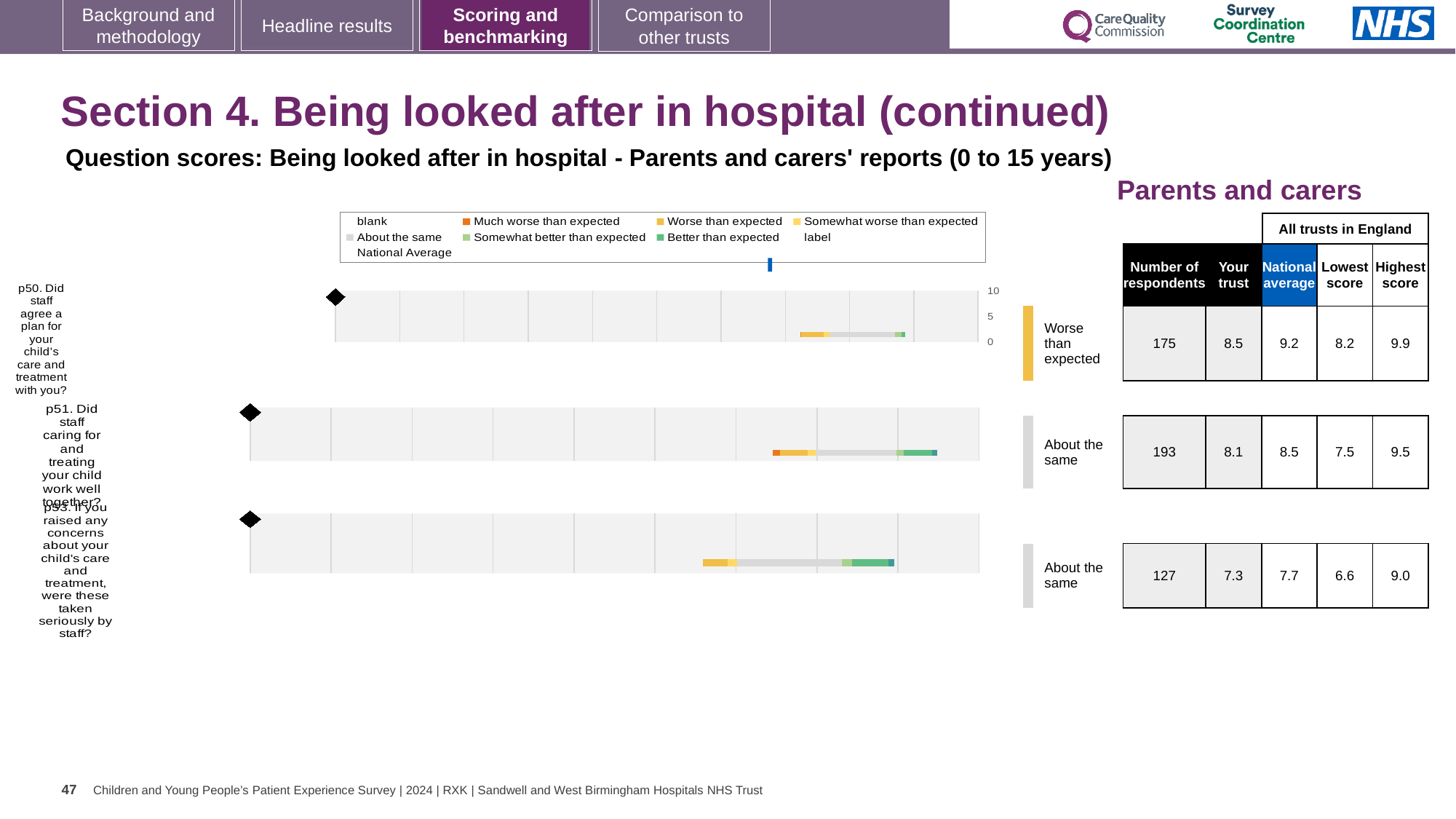
For p53, what is the difference between the national average and the 'Your trust' score? 0.4 What is the 'Your trust' score for p50 (Did staff agree a plan for your child's care and treatment with you?)? 8.5 What is the national average score for p51 (Did staff caring for and treating your child work well together?)? 8.5 Which question has the lowest national average score? p53 What benchmark category is shown for p50? Worse than expected What is the highest score across all trusts in England for p50? 9.9 What kind of chart is used to show the question scores? Bar chart For p51, which is larger: the 'Your trust' score or the national average? National average How many questions are charted on this slide? 3 How many respondents are shown for p53 (If you raised any concerns about your child's care and treatment, were these taken seriously by staff?)? 127 What is the lowest score across all trusts in England for p53? 6.6 Which question has the highest 'Your trust' score? p50